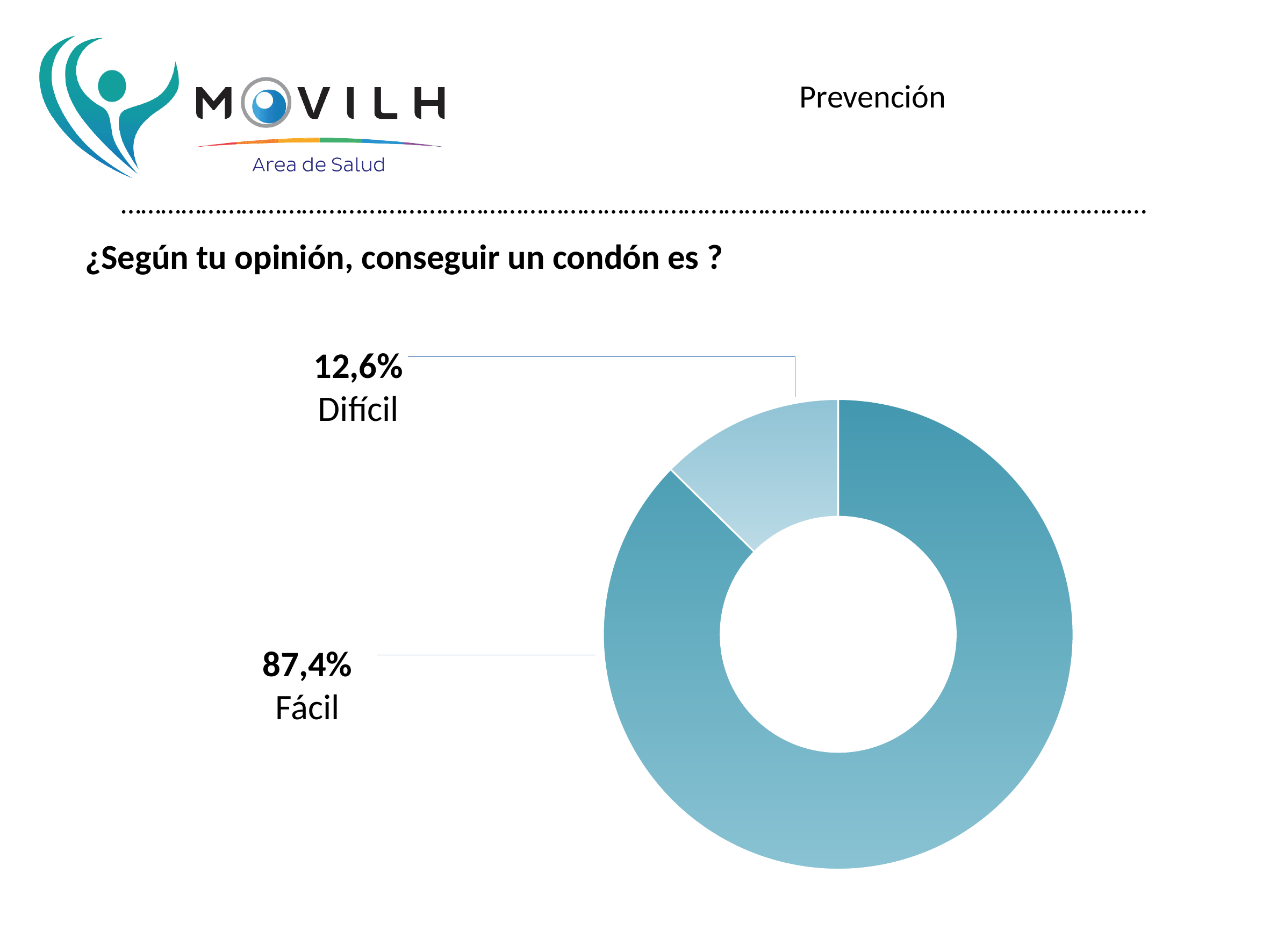
Which category has the largest share of the pie? Fácil What question does the chart answer, according to the slide? ¿Según tu opinión, conseguir un condón es ? What share of the pie does the Difícil slice represent? 12,6% What percentage of respondents said getting a condom is Difícil? 12,6% What is the difference in percentage points between Fácil and Difícil? 74,8 Which slice is shown in the lighter blue colour? Difícil Which category has the smallest share of the pie? Difícil How many categories are shown in the chart? 2 What kind of chart is shown on the slide? Pie chart (donut) Which is larger, the share for Fácil or the share for Difícil? Fácil What percentage of respondents said getting a condom is Fácil? 87,4%